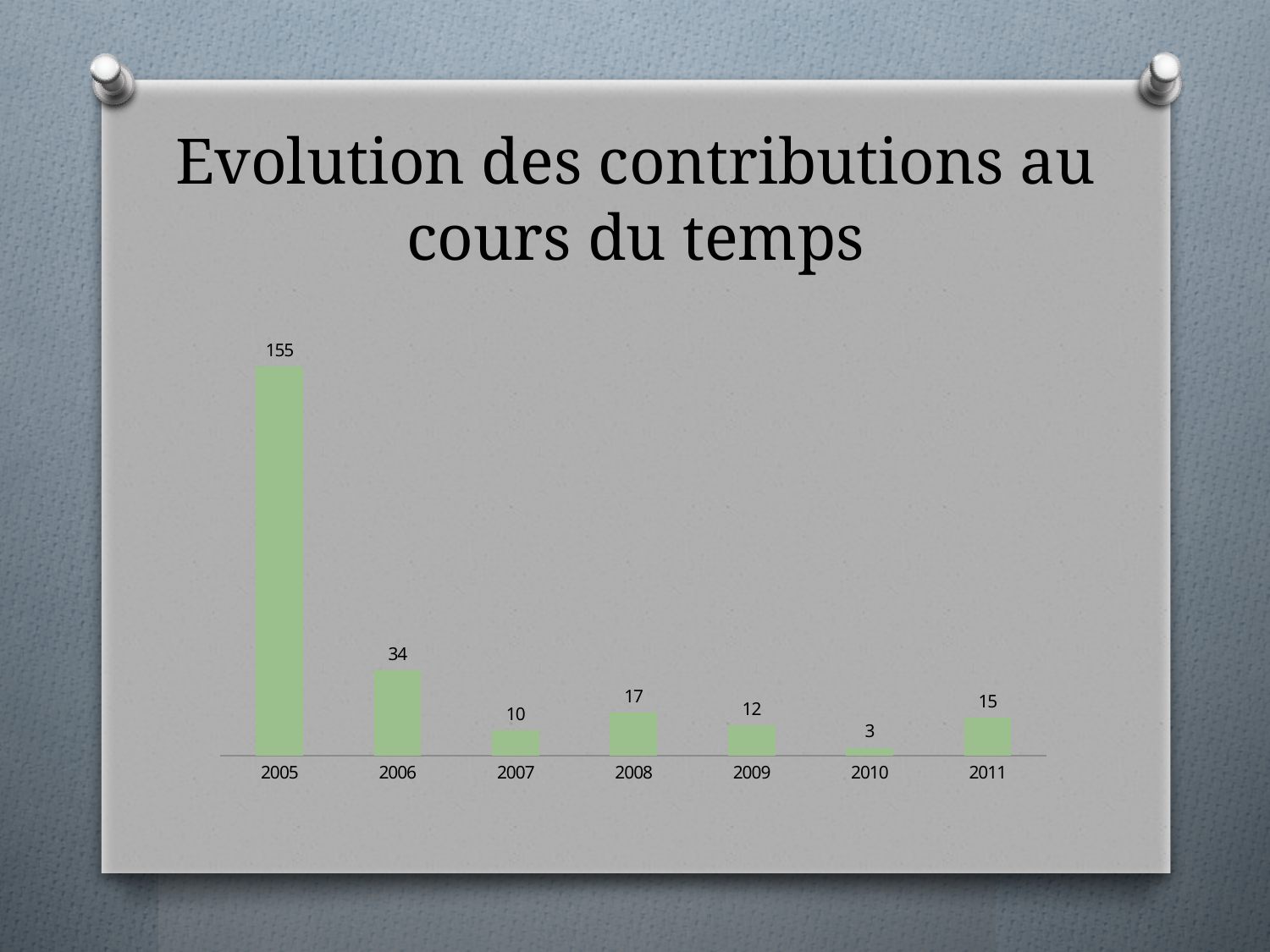
What is the difference between the values for 2005 and 2006? 121 What kind of chart is shown on the slide? bar chart What is the value for 2006? 34 What is the title of the slide? Evolution des contributions au cours du temps What is the value for 2011? 15 Which year has the lowest value? 2010 What is the value for 2005? 155 How many years are shown on the x axis? 7 What is the difference between the values for 2008 and 2009? 5 What is the value for 2010? 3 Which is larger, the value for 2007 or the value for 2011? 2011 Which year has the highest value? 2005